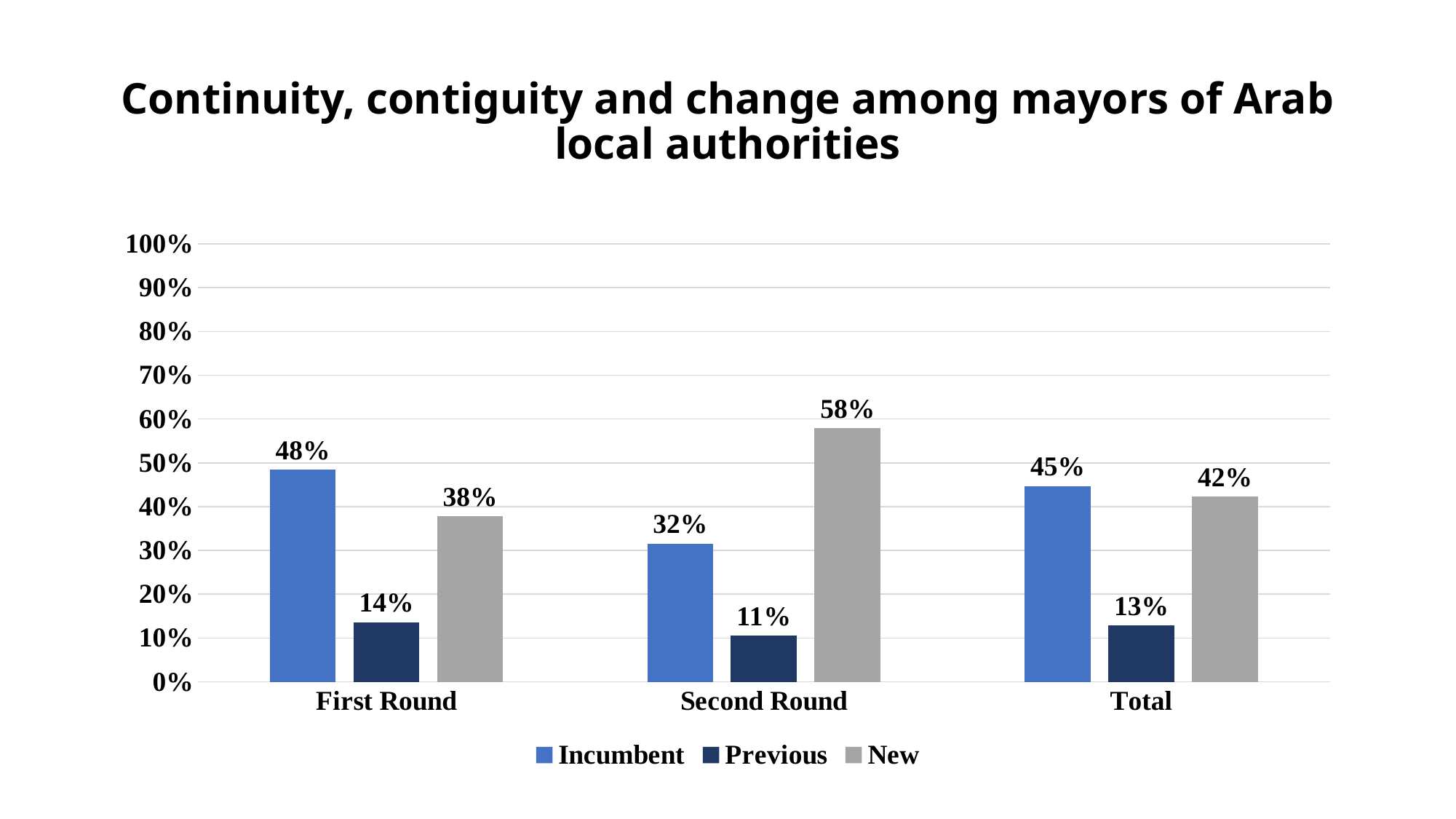
How many series does the legend list? 3 Which category has the lowest value for the Previous series? Second Round What is the value for New in the Second Round? 58% What kind of chart is shown on the slide? Bar chart What is the difference between the Incumbent and Previous values in the First Round? 34% What is the value for Incumbent in the First Round? 48% What colour are the bars for the New series? Grey In the Second Round, which is larger: Incumbent or New? New Is the value for Incumbent in the Total category greater or less than 40%? greater How many categories are shown on the x axis? 3 Which category has the highest value for the New series? Second Round What is the value for Previous in the Total category? 13%